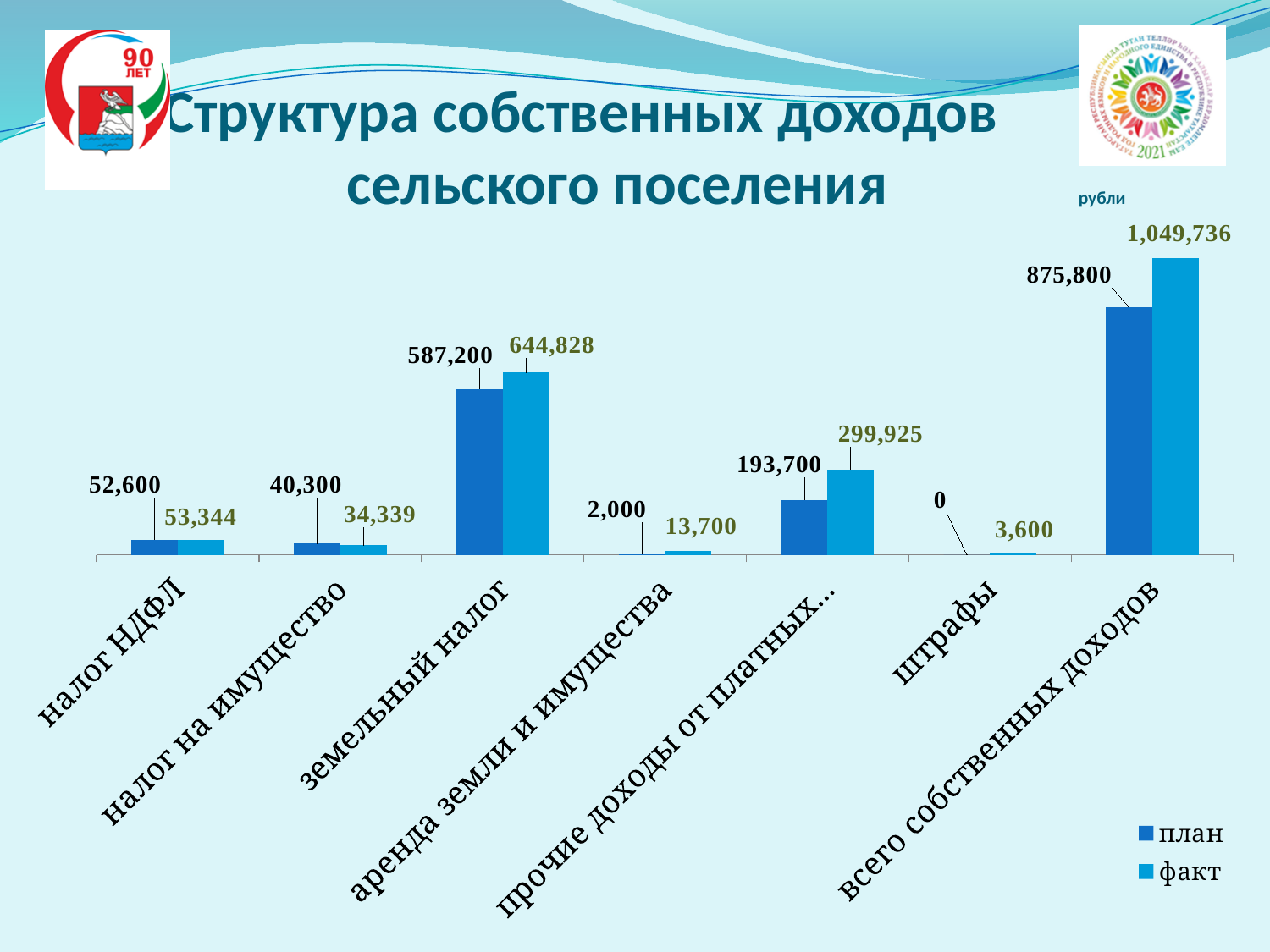
Which is larger for земельный налог, the план value or the факт value? факт Which category has the highest факт value? всего собственных доходов What is the факт value for прочие доходы от платных...? 299,925 What is the план value for земельный налог? 587,200 What is the факт value for штрафы? 3,600 Which category has the lowest план value? штрафы What kind of chart is shown on the slide? bar chart What is the difference between the план and факт values for налог на имущество? 5,961 How many categories are shown on the x axis? 7 What is the difference between the факт and план values for всего собственных доходов? 173,936 How many series does the legend list? 2 What is the план value for аренда земли и имущества? 2,000